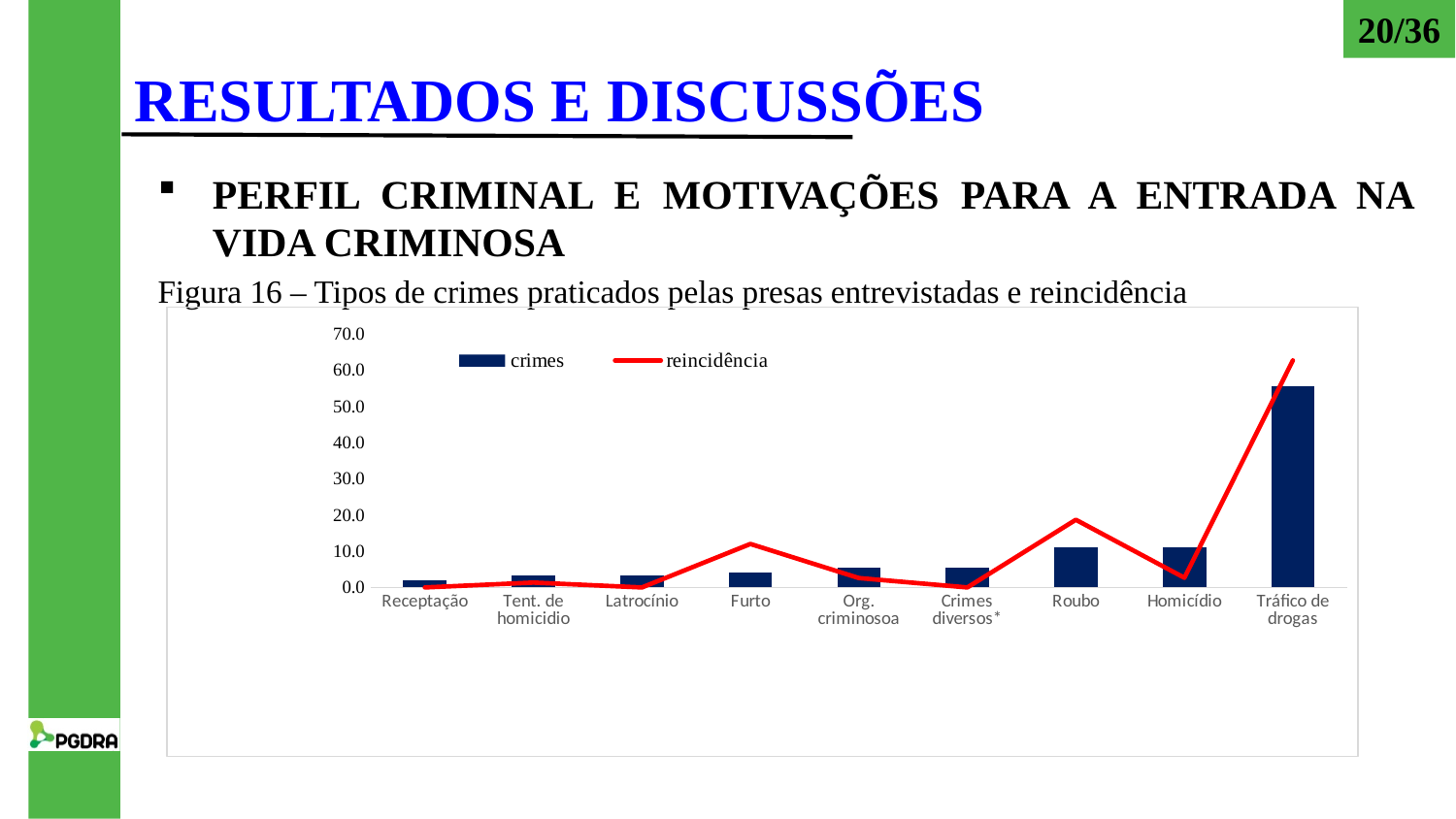
Is the reincidência value for Tráfico de drogas greater or less than 50.0? greater Which has the larger crimes value, Roubo or Tráfico de drogas? Tráfico de drogas How many series does the chart legend list? 2 Is the crimes value for Tráfico de drogas greater or less than 50.0? greater What colour is the reincidência line in the chart? Red Which category has the highest value for the reincidência series? Tráfico de drogas How many crime categories are shown on the x axis of the chart? 9 Is the crimes value for Receptação greater or less than 10.0? less What are the two series named in the chart legend? crimes and reincidência Which has the larger reincidência value, Roubo or Homicídio? Roubo Which category has the highest value for the crimes series? Tráfico de drogas